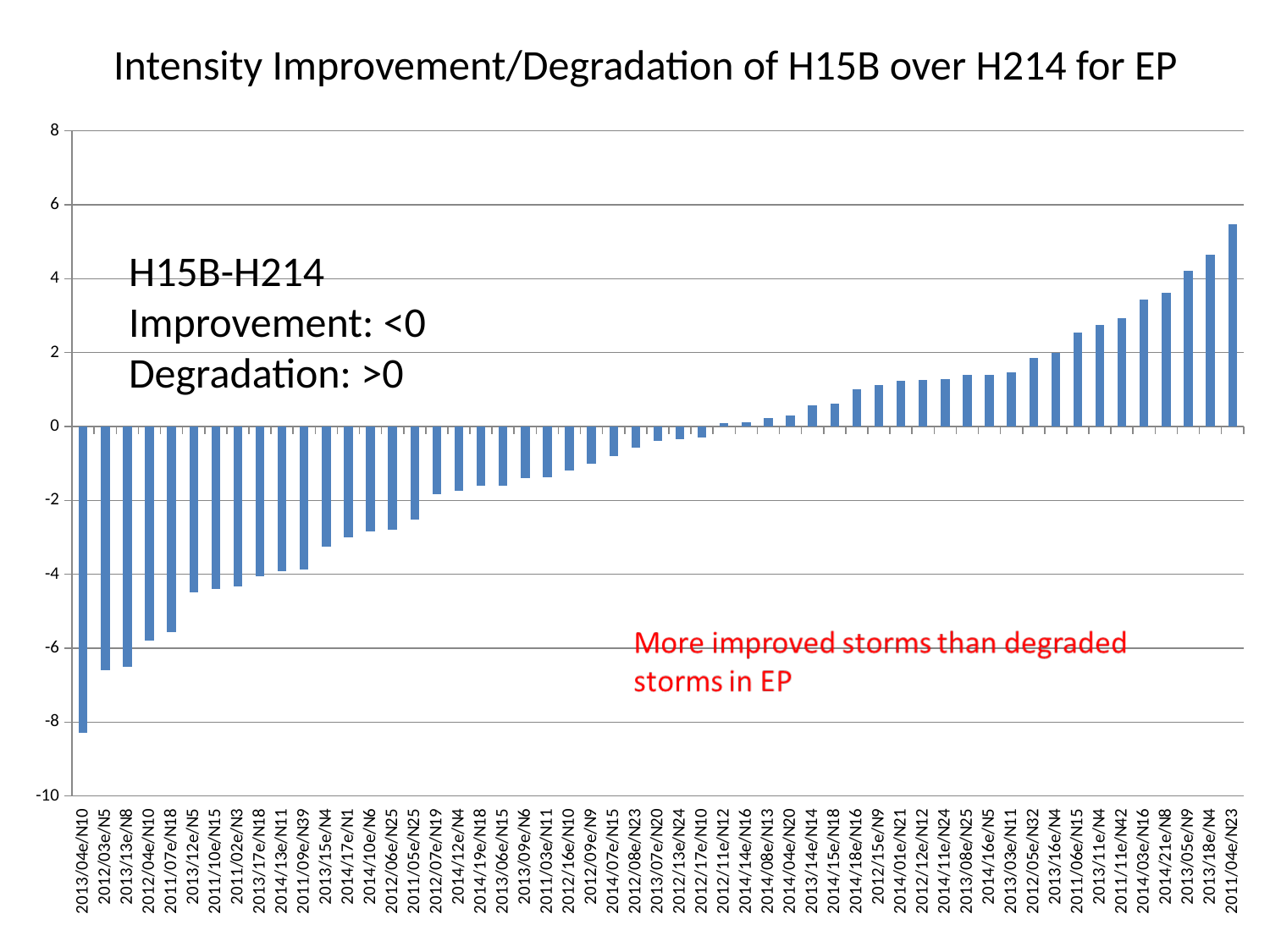
Which has the lower value, 2013/04e/N10 or 2012/03e/N5? 2013/04e/N10 Which category has the highest value? 2011/04e/N23 Is the value for 2011/06e/N15 greater or less than 2? greater According to the red annotation on the chart, are there more improved or more degraded storms in EP? more improved storms What kind of chart is shown on the slide? bar chart Do the values rise or fall moving from left to right along the x axis? rise Is the value for 2013/18e/N4 greater or less than 4? greater Is the value for 2011/04e/N23 greater or less than 4? greater What is the title of the chart? Intensity Improvement/Degradation of H15B over H214 for EP Which category has the lowest value? 2013/04e/N10